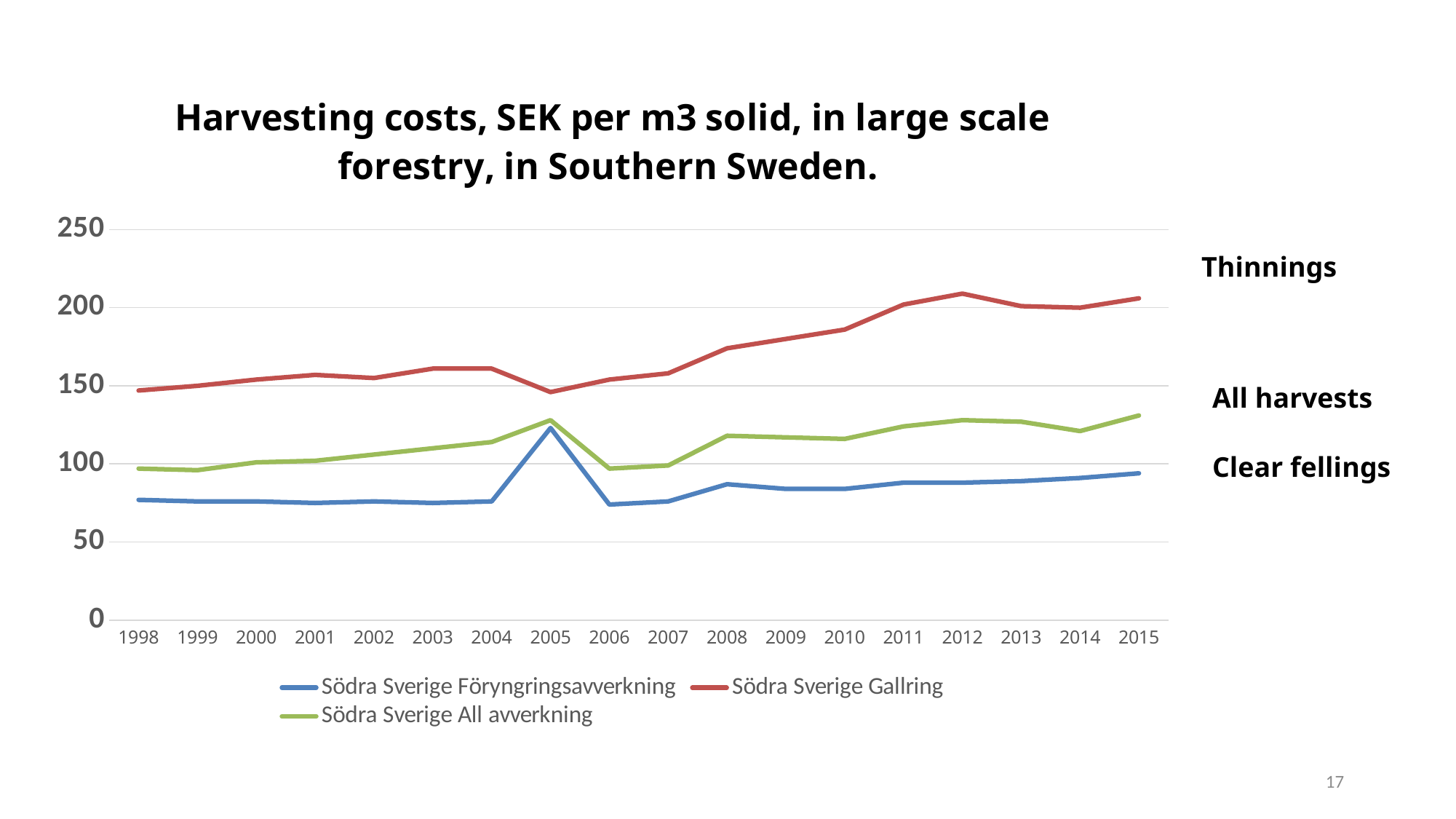
Is the value for Södra Sverige Föryngringsavverkning in 2005 greater or less than 100? greater Is the value for Södra Sverige Gallring in 2005 greater or less than 150? less Is the value for Södra Sverige All avverkning in 1998 greater or less than 100? less Does the Södra Sverige Gallring series rise or fall from 2008 to 2012? rise In which year does Södra Sverige Föryngringsavverkning reach its highest value? 2005 What kind of chart is shown on the slide? line chart Which series is drawn in red? Södra Sverige Gallring How many series does the legend list? 3 Which series has the larger value in 2010, Södra Sverige Gallring or Södra Sverige All avverkning? Södra Sverige Gallring Which year has the larger value for Södra Sverige Föryngringsavverkning, 2005 or 2006? 2005 How many years are plotted along the x axis? 18